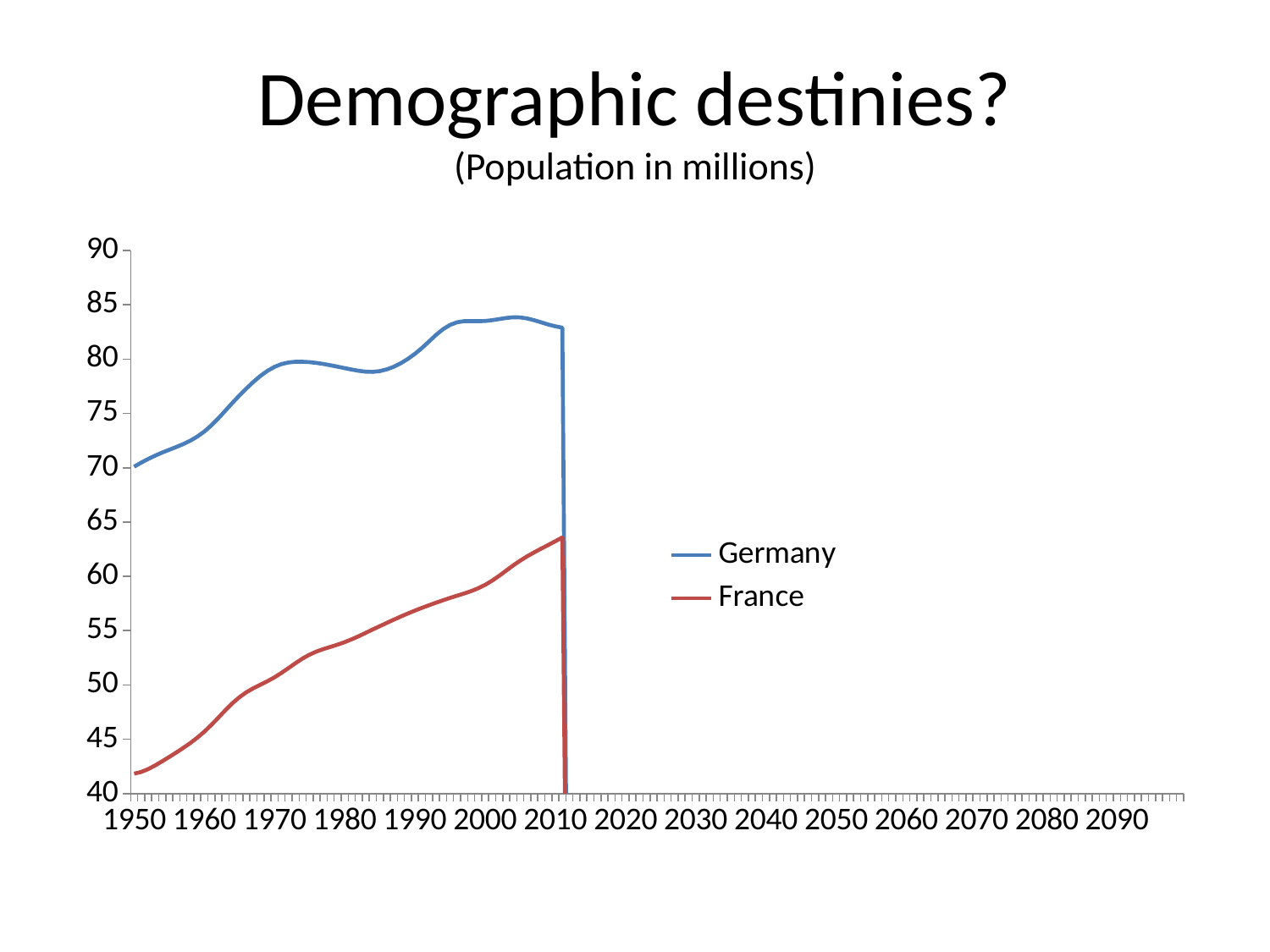
In 2000, which series has the larger value, Germany or France? Germany Does the France line rise or fall from 1950 to 2010? rise Is the value for Germany in 1950 greater or less than 75? less Which two countries are plotted in the chart? Germany and France Is the value for Germany in 1960 greater or less than 70? greater What kind of chart is shown on the slide? line chart Is the value for France in 1950 greater or less than 45? less What is the title of the chart on the slide? Demographic destinies? How many series does the legend list? 2